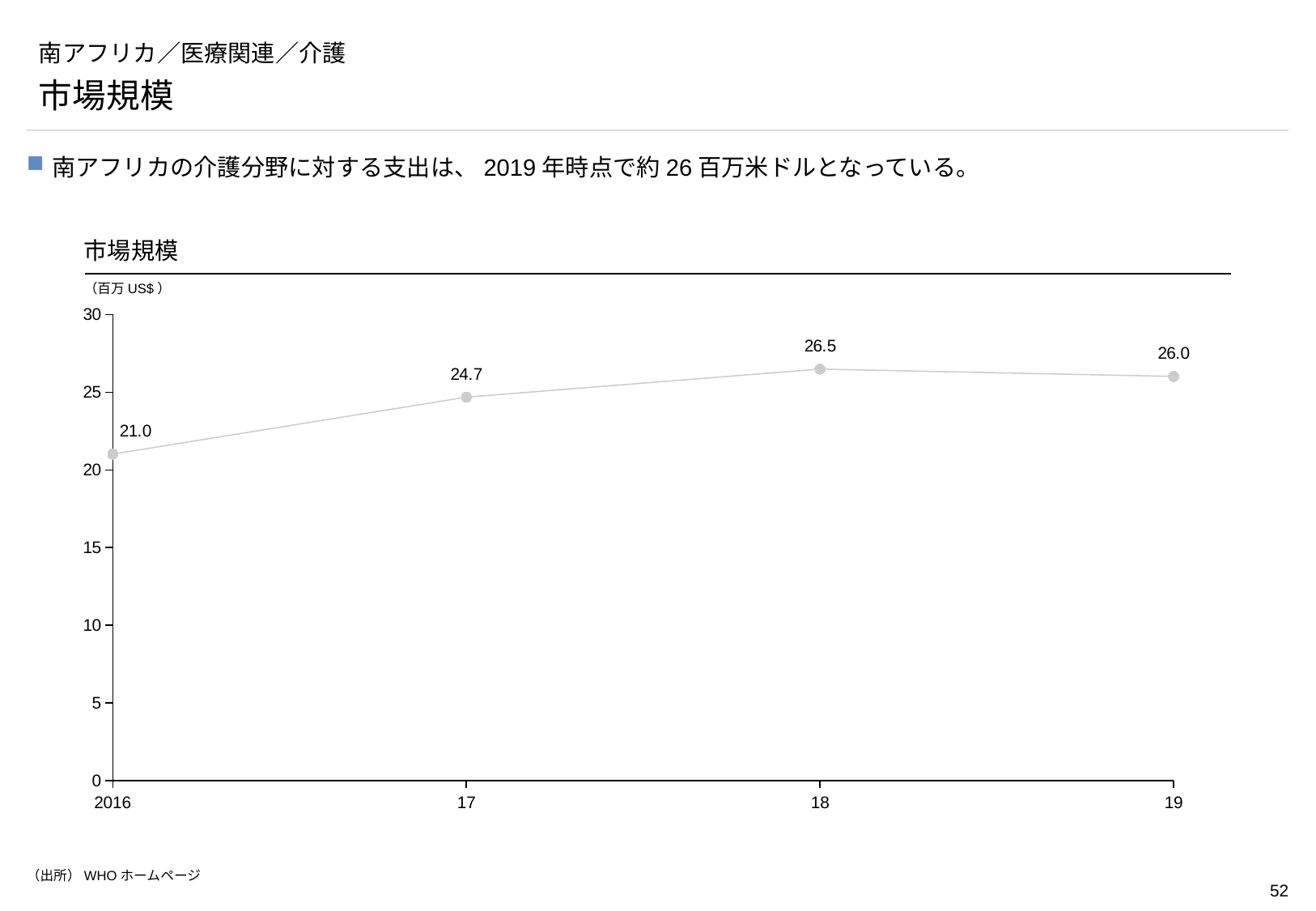
What kind of chart is shown on the slide? line chart Which year has the highest value? 2018 What unit is shown for the chart's values? 百万 US$ Which year has the lowest value? 2016 Which is larger, the value for 2017 or the value for 2019? 2019 What is the value for 2019? 26.0 How many data points are plotted on the chart? 4 What is the value for 2018? 26.5 Do the values rise or fall from 2016 to 2018? rise What is the difference between the values for 2018 and 2016? 5.5 What is the value for 2016? 21.0 Is the value for 2017 greater or less than 20? greater